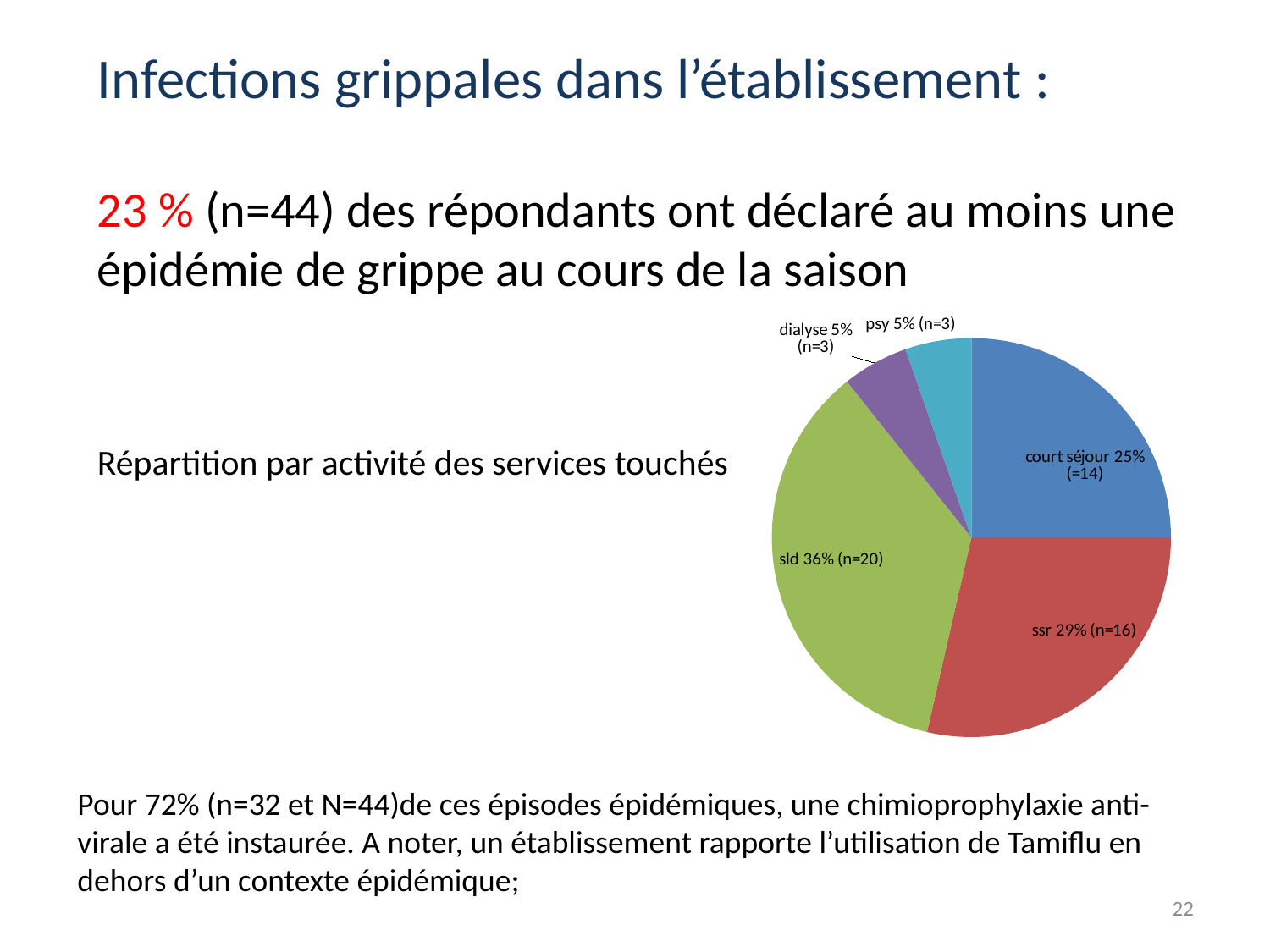
What is the difference between the n values of the sld slice and the ssr slice? 4 What is the n value shown for the sld slice? 20 What is the n value shown for the court séjour slice? 14 What percentage of the pie does the sld slice represent? 36% What percentage is shown for the ssr slice? 29% Which slice of the pie chart is the largest? sld What is the difference in percentage points between the sld slice and the ssr slice? 7 What kind of chart is shown on the slide? pie chart How many slices does the pie chart have? 5 What colour is the ssr slice of the pie chart? red What percentage is shown for the dialyse slice? 5% Which slice is larger, ssr or court séjour? ssr